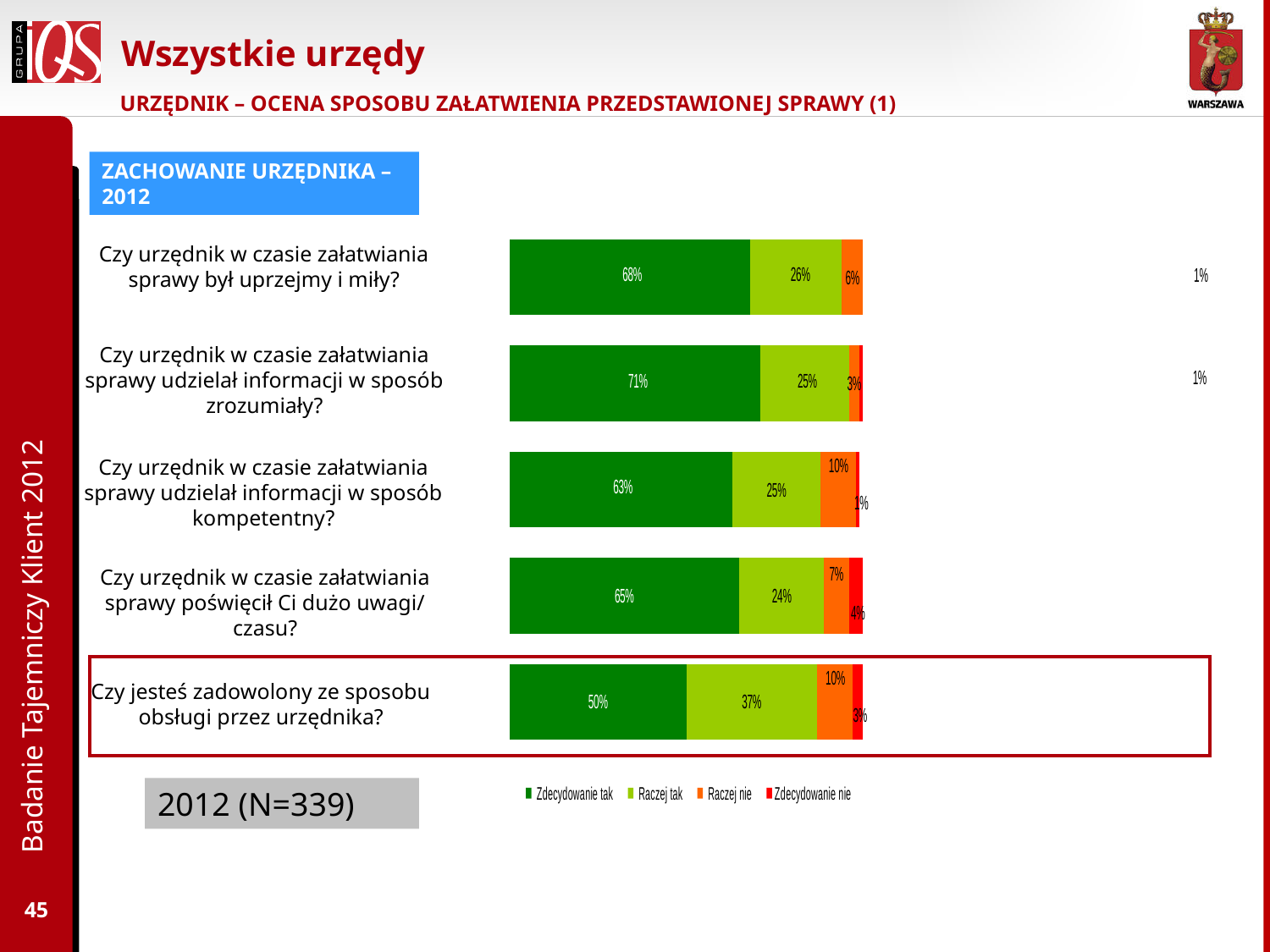
How many series does the legend list? 4 What is the difference between the 'Zdecydowanie tak' values for 'udzielał informacji w sposób zrozumiały?' and 'był uprzejmy i miły?'? 3% What is the 'Raczej nie' value for 'Czy urzędnik w czasie załatwiania sprawy udzielał informacji w sposób kompetentny?'? 10% How many questions (categories) are plotted in the chart? 5 What kind of chart is shown on the slide? stacked bar chart What is the sample size shown on the slide for 2012? N=339 What is the 'Zdecydowanie nie' value for 'Czy urzędnik w czasie załatwiania sprawy poświęcił Ci dużo uwagi/czasu?'? 4% What is the 'Raczej tak' value for 'Czy jesteś zadowolony ze sposobu obsługi przez urzędnika?'? 37% Which is larger: the 'Raczej tak' value for 'był uprzejmy i miły?' or for 'poświęcił Ci dużo uwagi/czasu?'? był uprzejmy i miły? (26%) Which question has the lowest 'Zdecydowanie tak' share? Czy jesteś zadowolony ze sposobu obsługi przez urzędnika? What is the 'Zdecydowanie tak' value for 'Czy urzędnik w czasie załatwiania sprawy był uprzejmy i miły?'? 68% Which question has the highest 'Zdecydowanie tak' share? Czy urzędnik w czasie załatwiania sprawy udzielał informacji w sposób zrozumiały?